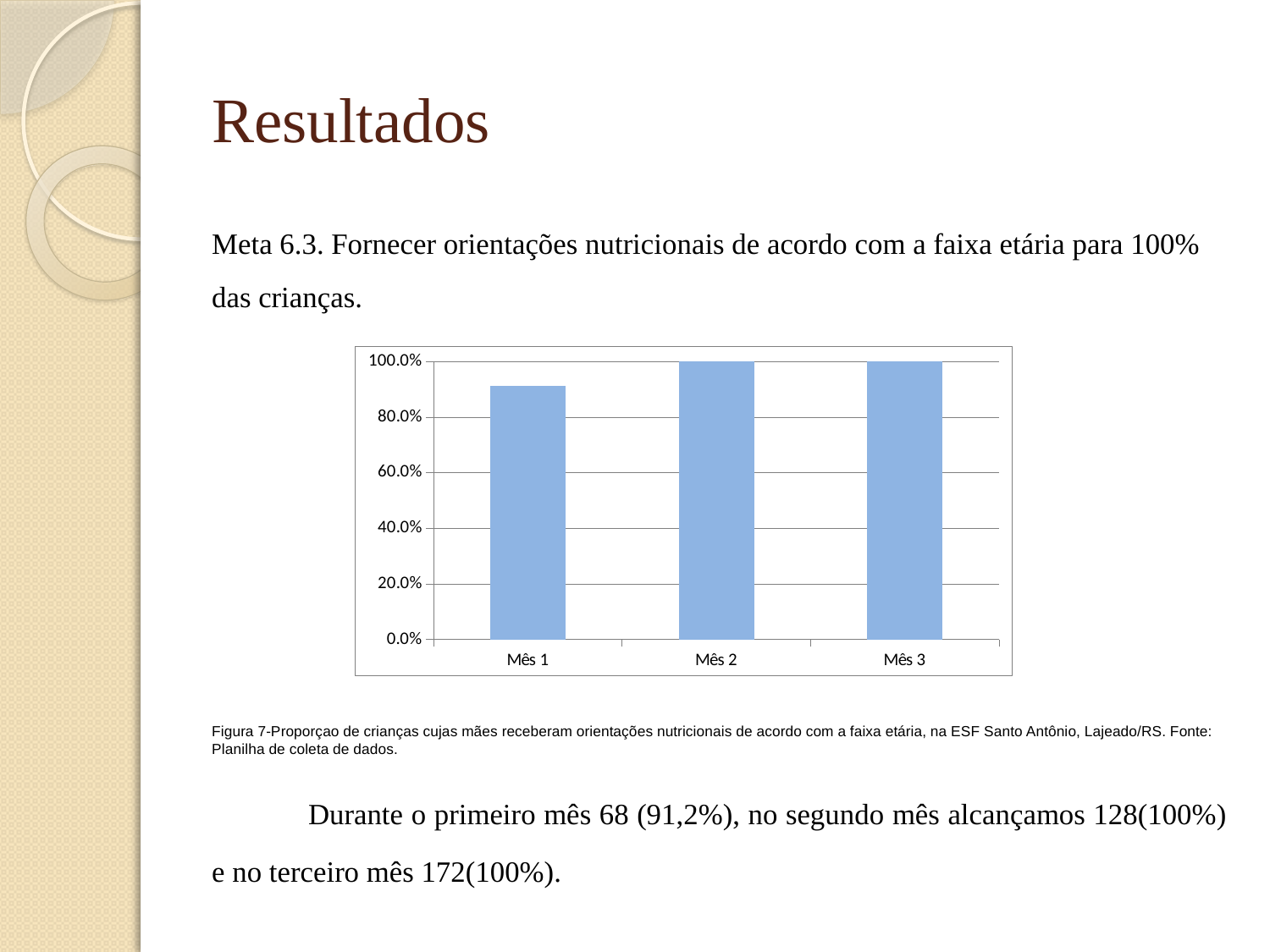
Is the value for Mês 1 greater or less than 80.0%? greater What is the value for Mês 2 in the chart? 100.0% How many categories are plotted on the x axis of the chart? 3 Is the value for Mês 1 greater or less than 100.0%? less What is the value for Mês 3 in the chart? 100.0% What is the label of the first category on the x axis of the chart? Mês 1 What kind of chart is shown on the slide? bar chart Which month has the lowest value in the chart? Mês 1 Which is larger, the value for Mês 1 or the value for Mês 2? Mês 2 What is the highest tick label shown on the y axis of the chart? 100.0% Does the value rise or fall from Mês 1 to Mês 2? rise